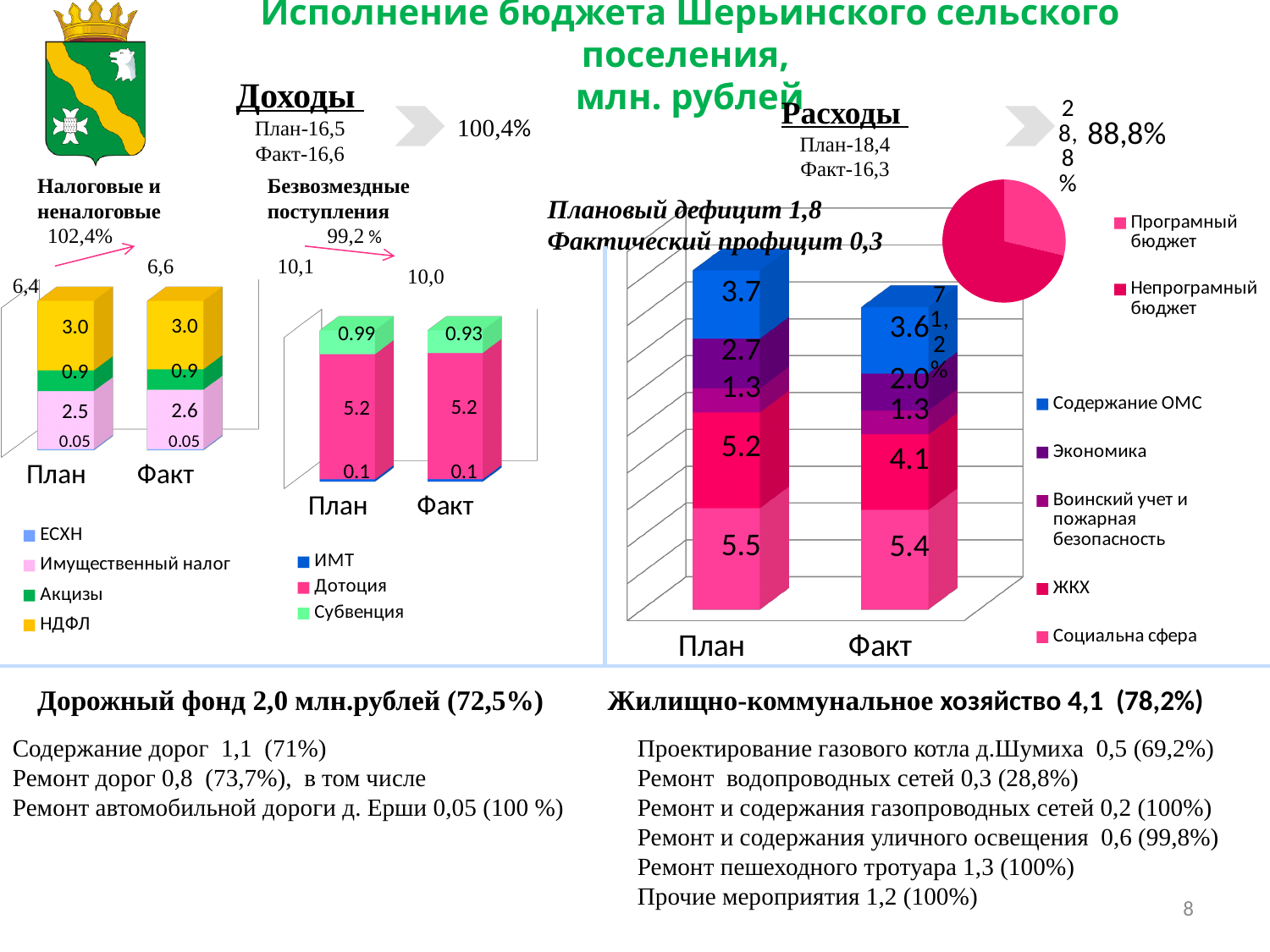
In the 'Безвозмездные поступления' chart, how many series does the legend list? 3 In the 'Расходы' chart, what is the value of Содержание ОМС for План? 3.7 In the 'Налоговые и неналоговые' chart, what is the difference between the Имущественный налог values for Факт and План? 0.1 In the 'Расходы' chart, which is larger: Экономика for План or Экономика for Факт? План In the 'Налоговые и неналоговые' chart, what is the value of НДФЛ for План? 3.0 In the 'Расходы' chart, what is the difference between ЖКХ for План and ЖКХ for Факт? 1.1 In the 'Безвозмездные поступления' chart, what is the value of Субвенция for План? 0.99 In the 'Налоговые и неналоговые' chart, how many series does the legend list? 4 In the 'Безвозмездные поступления' chart, which series has the largest value in the Факт bar? Дотоция In the 'Налоговые и неналоговые' chart, what is the value of Имущественный налог for Факт? 2.6 In the pie chart on the right, which slice is larger: Програмный бюджет or Непрограмный бюджет? Непрограмный бюджет In the 'Расходы' chart, what is the value of ЖКХ for Факт? 4.1